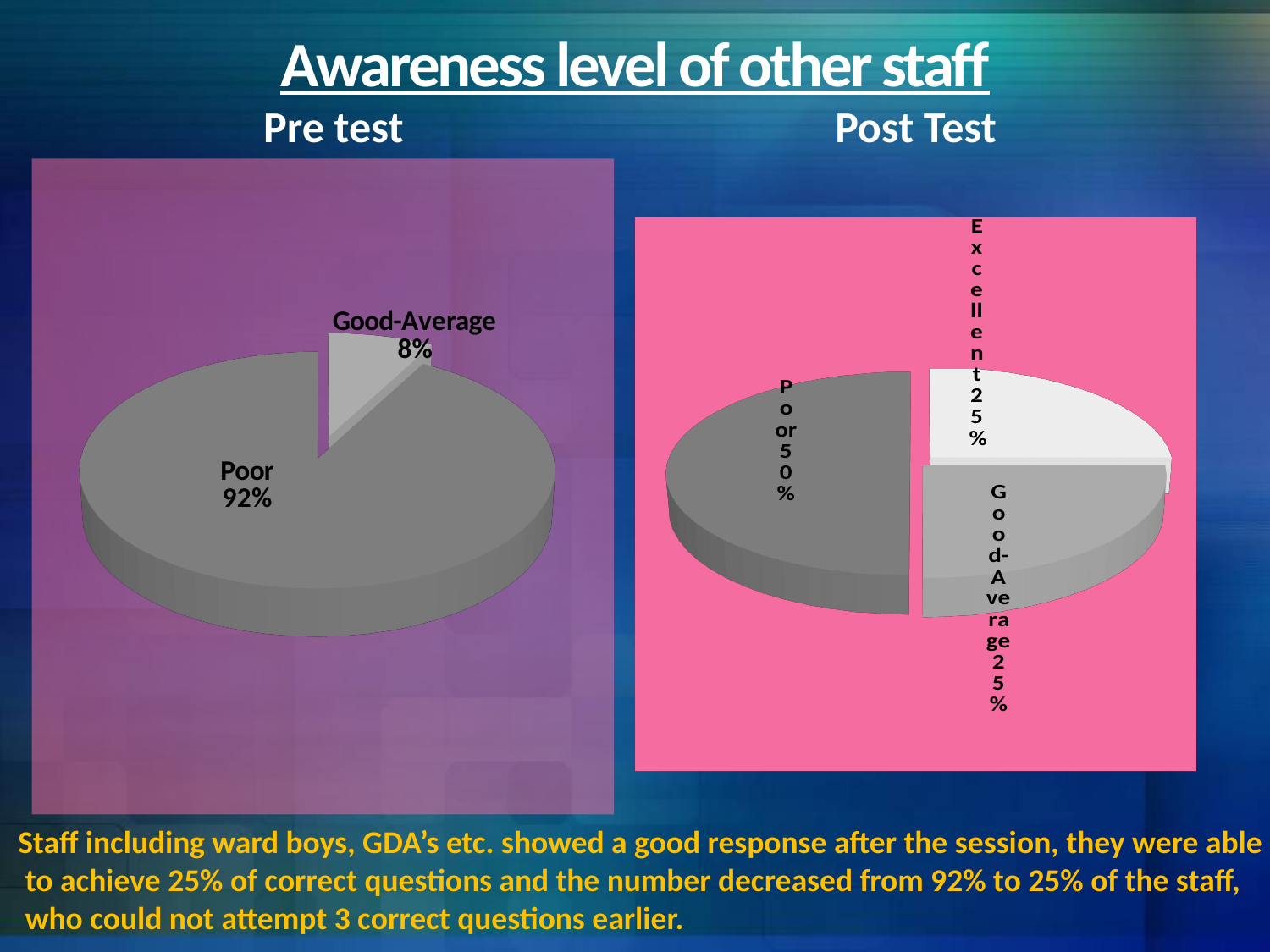
In the Post Test chart, how many slices does the pie have? 3 In the Post Test chart, which category has the largest slice? Poor What is the title of the slide containing the two pie charts? Awareness level of other staff In the Pre test chart, how many slices does the pie have? 2 In the Pre test chart, which category has the largest slice? Poor In the Pre test chart, what is the difference between the Poor and Good-Average shares? 84% In the Pre test chart, what share of staff is labelled Poor? 92% Which chart has the larger Poor share, Pre test or Post Test? Pre test In the Post Test chart, what share of staff is labelled Excellent? 25% In the Post Test chart, what share of staff is labelled Poor? 50% In the Pre test chart, what share of staff is labelled Good-Average? 8% What kind of chart is the Pre test chart? pie chart